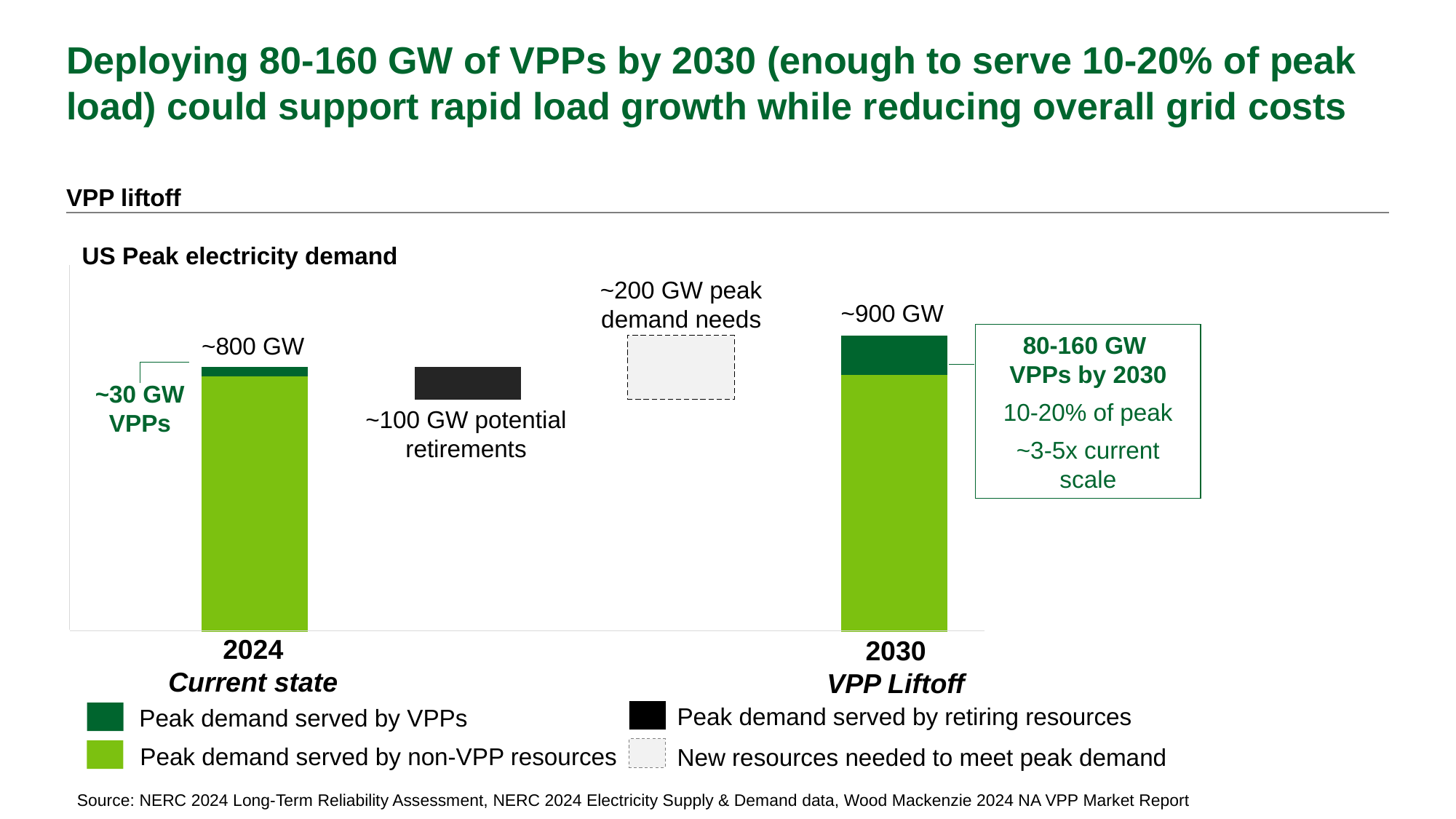
Which year has the lowest peak electricity demand bar? 2024 Which year has the taller bar for US peak electricity demand, 2024 or 2030? 2030 According to the legend, what does the dark green colour represent? Peak demand served by VPPs What value label is printed above the 2030 bar? ~900 GW What label is printed next to the dark green segment of the 2024 bar? ~30 GW VPPs Does US peak electricity demand rise or fall from 2024 to 2030 in the chart? rise What value label is printed above the 2024 bar? ~800 GW How many years are shown as bars on the x axis of the chart? 2 What kind of chart is shown on the slide? bar chart What is the title of the chart? US Peak electricity demand What label is printed next to the black block between the two bars? ~100 GW potential retirements How many entries does the chart legend list? 4